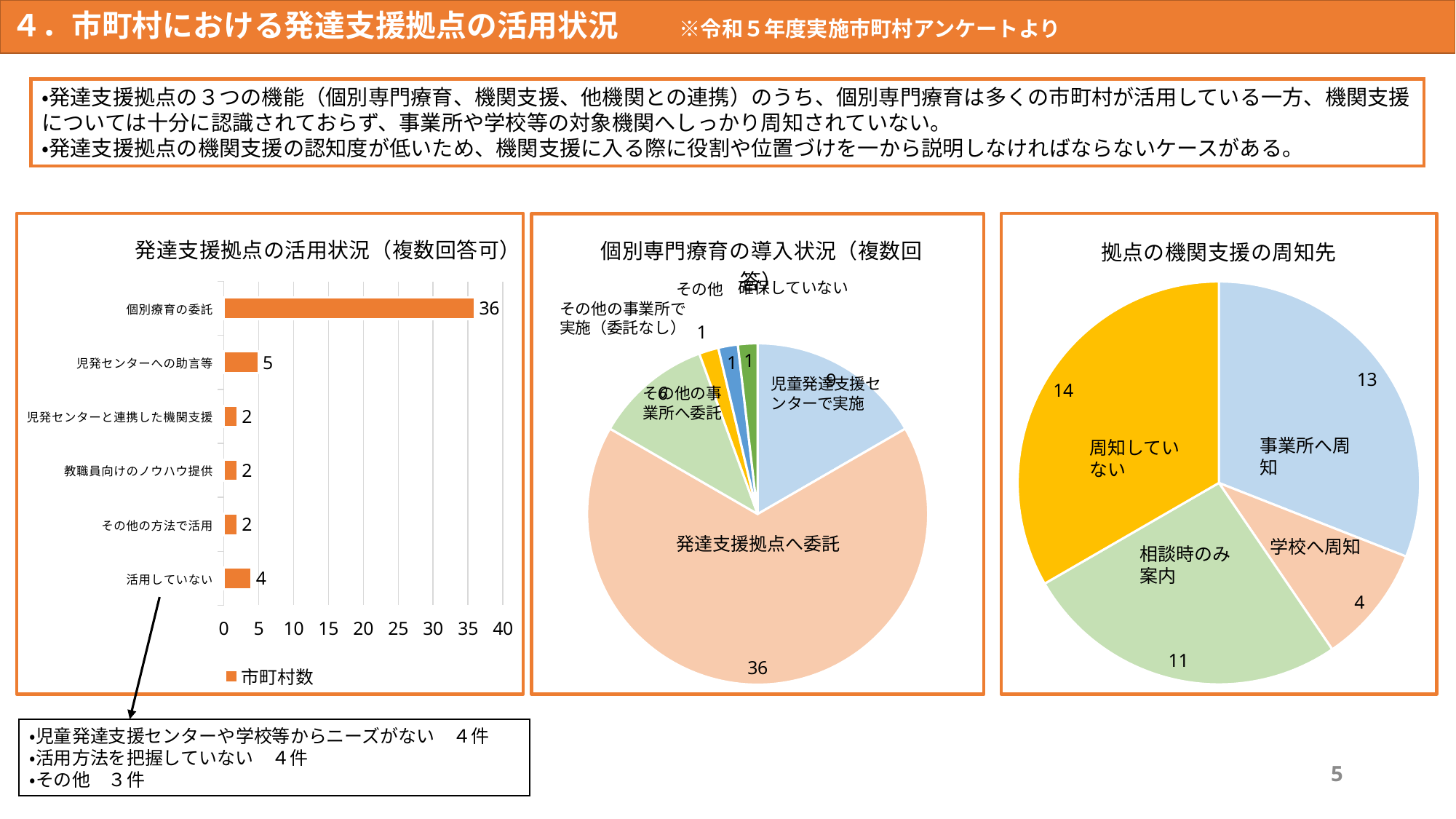
In the bar chart titled 発達支援拠点の活用状況（複数回答可）, which category has the highest value? 個別療育の委託 In the pie chart titled 拠点の機関支援の周知先, what is the difference between 周知していない and 学校へ周知? 10 In the pie chart titled 拠点の機関支援の周知先, what is the value for 事業所へ周知? 13 In the bar chart titled 発達支援拠点の活用状況（複数回答可）, what is the value for 個別療育の委託? 36 In the bar chart titled 発達支援拠点の活用状況（複数回答可）, what series name does the legend show? 市町村数 What kind of chart is the right chart titled 拠点の機関支援の周知先? pie chart What kind of chart is the left chart titled 発達支援拠点の活用状況（複数回答可）? bar chart In the bar chart titled 発達支援拠点の活用状況（複数回答可）, how many categories are shown? 6 In the pie chart titled 個別専門療育の導入状況（複数回答可）, which slice is the largest? 発達支援拠点へ委託 In the bar chart titled 発達支援拠点の活用状況（複数回答可）, what is the value for 活用していない? 4 In the bar chart titled 発達支援拠点の活用状況（複数回答可）, what is the difference between 個別療育の委託 and 児発センターへの助言等? 31 In the pie chart titled 個別専門療育の導入状況（複数回答可）, what is the value for 発達支援拠点へ委託? 36